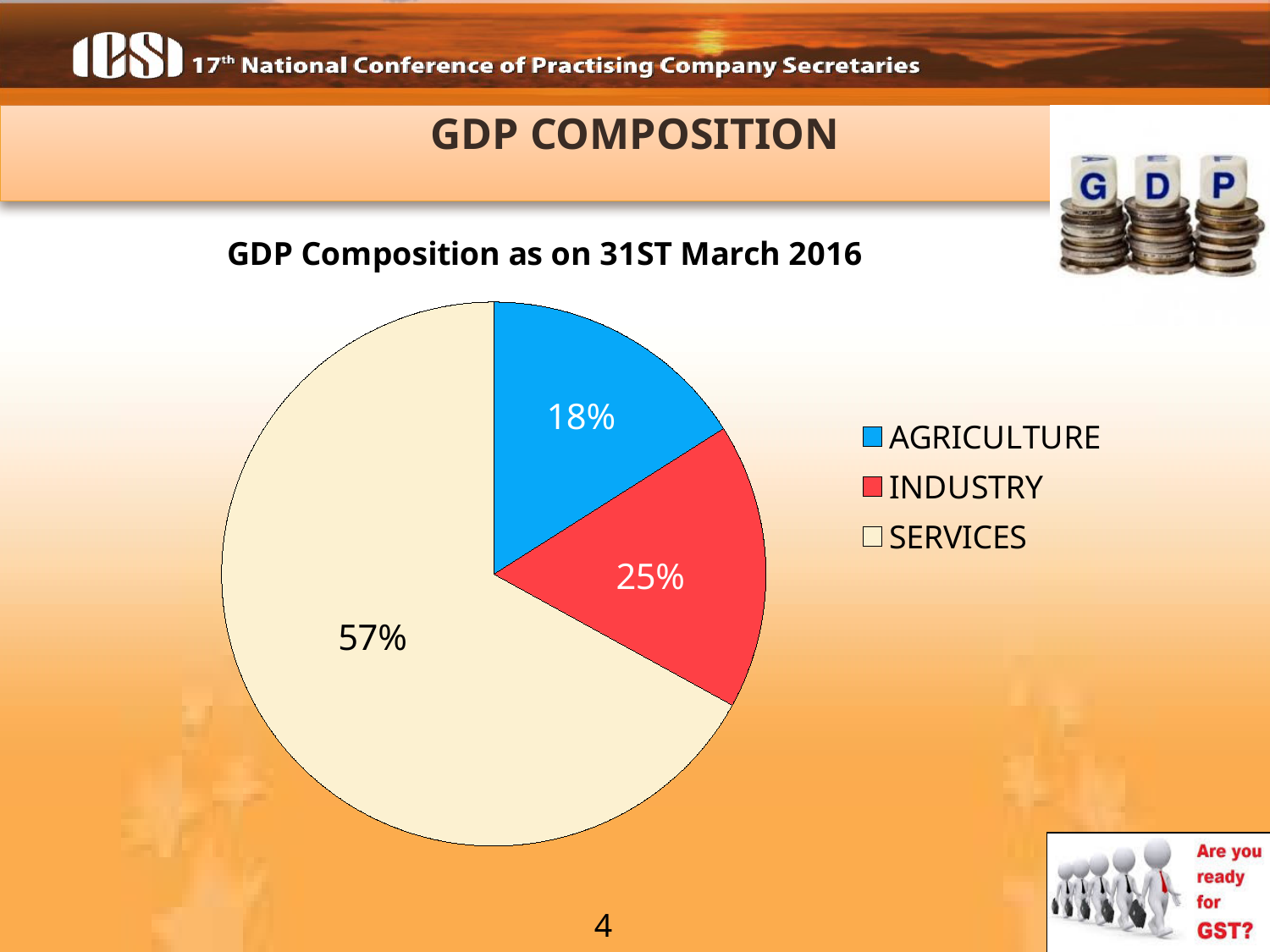
Which is larger, the share for INDUSTRY or the share for AGRICULTURE? INDUSTRY What share of GDP does SERVICES account for? 57% What share of GDP does INDUSTRY account for? 25% What share of GDP does AGRICULTURE account for? 18% What is the difference in percentage points between the SERVICES share and the INDUSTRY share? 32 What is the title of the chart? GDP Composition as on 31ST March 2016 How many slices does the pie chart have? 3 Which sector has the largest share of GDP? SERVICES Which sector has the smallest share of GDP? AGRICULTURE What is the difference in percentage points between the INDUSTRY share and the AGRICULTURE share? 7 What colour is the INDUSTRY slice? red What kind of chart is shown on the slide? pie chart